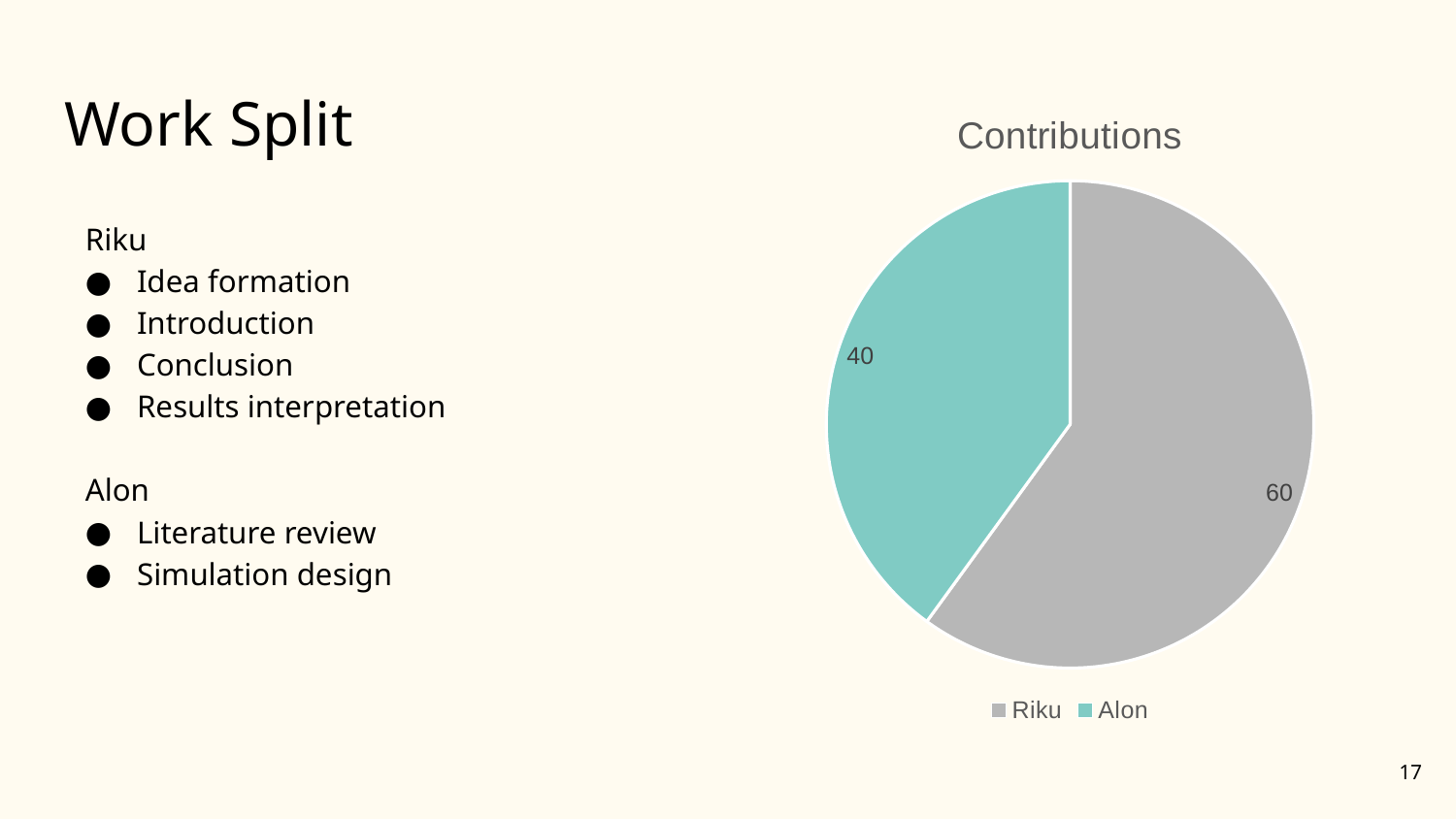
What kind of chart is shown on the slide? Pie chart What is the value for Alon in the Contributions pie chart? 40 What is the difference between Riku's and Alon's values in the Contributions pie chart? 20 How many slices does the Contributions pie chart have? 2 Which category has the smallest slice in the Contributions pie chart? Alon What is the title of the chart on the slide? Contributions What is the value for Riku in the Contributions pie chart? 60 Which category has the largest slice in the Contributions pie chart? Riku What share of the Contributions pie does Alon's slice represent? 40% Which is larger in the Contributions pie chart, Riku or Alon? Riku What colour is Alon's slice in the Contributions pie chart? Teal How many entries does the legend of the Contributions chart list? 2